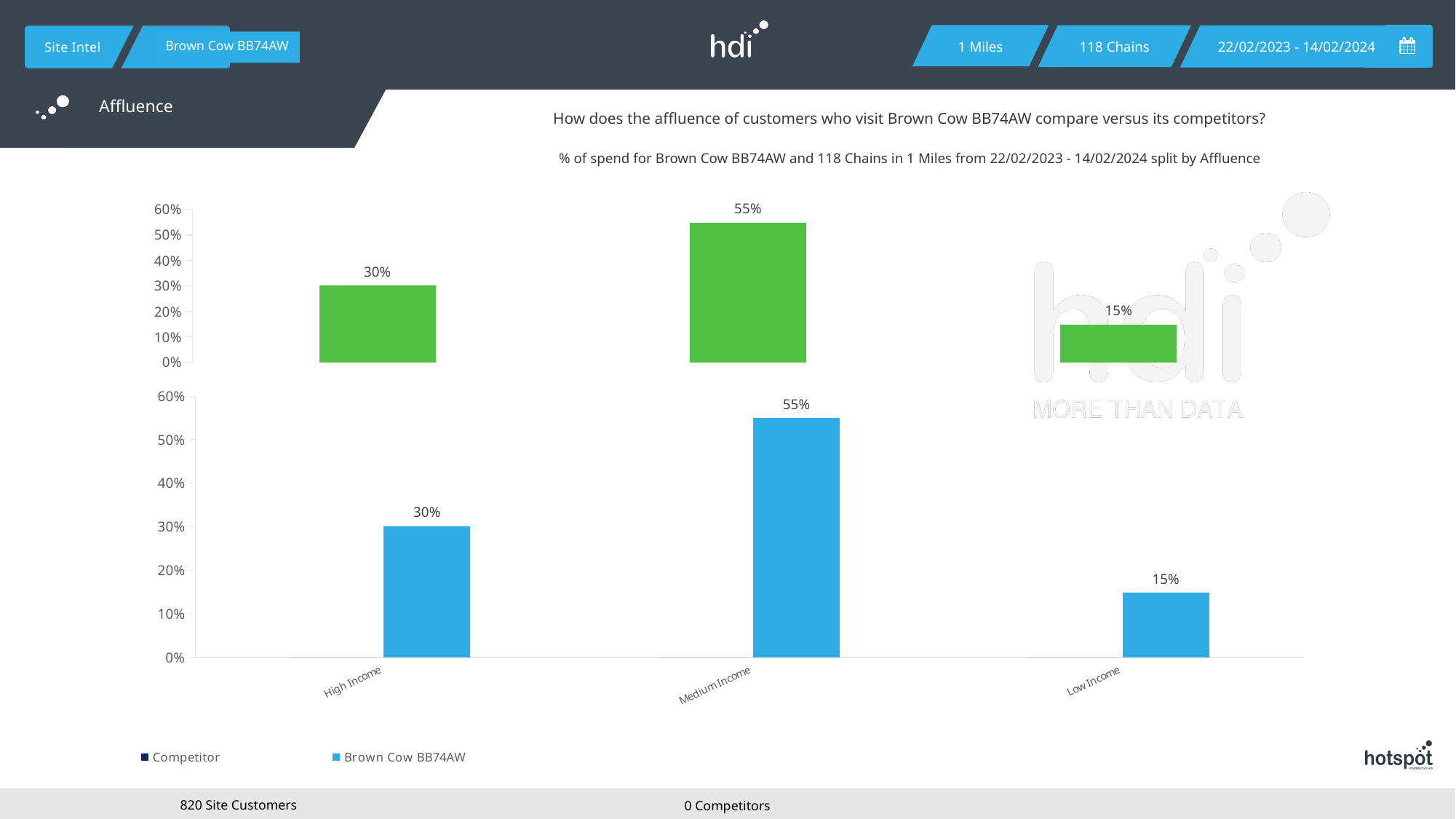
In the bottom chart, what is the difference between the values for Medium Income and High Income? 25% In the bottom chart, what is the value for High Income? 30% In the top chart, what is the value shown on the middle bar? 55% How many series does the legend at the bottom of the slide list? 2 In the bottom chart, which is larger, the value for High Income or the value for Low Income? High Income How many categories are shown on the x axis of the bottom chart? 3 In the bottom chart, what is the value for Low Income? 15% In the bottom chart, what is the value for Medium Income? 55% In the bottom chart, which category has the highest value? Medium Income In the bottom chart, which category has the lowest value? Low Income What kind of chart is the bottom chart? Bar chart In the top chart, what is the value shown on the rightmost bar? 15%